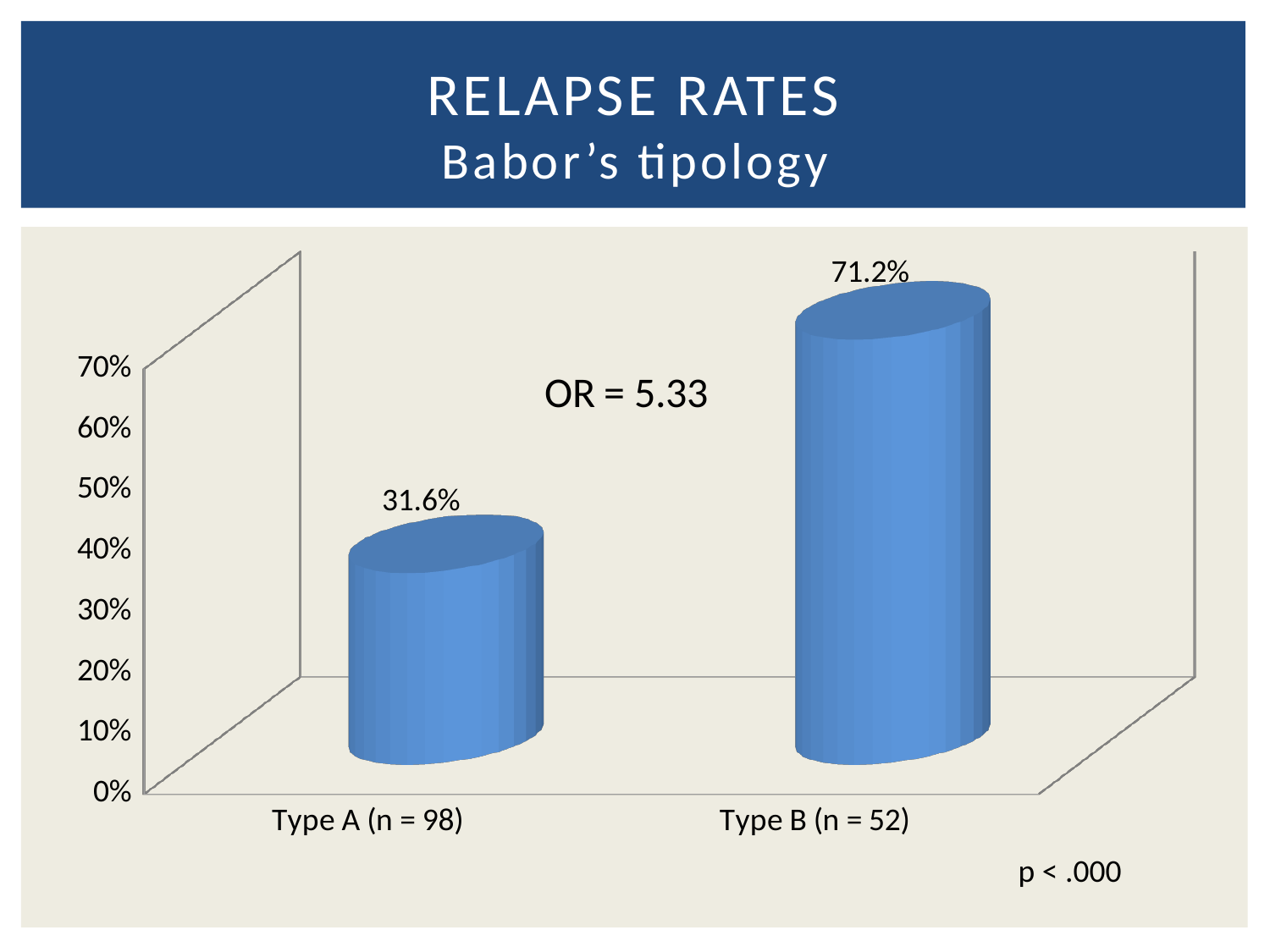
What is the relapse rate for Type A (n = 98)? 31.6% Is the relapse rate for Type B greater or less than 60%? greater Which category has the lowest relapse rate? Type A (n = 98) What kind of chart is shown on the slide? bar chart Which has a higher relapse rate, Type A or Type B? Type B What is the relapse rate for Type B (n = 52)? 71.2% Which category has the highest relapse rate? Type B (n = 52) What is the title of the slide? RELAPSE RATES Babor's tipology What odds ratio (OR) is printed on the chart? 5.33 Is the relapse rate for Type A greater or less than 40%? less What is the difference in relapse rate between Type B and Type A? 39.6% How many categories are shown on the chart? 2